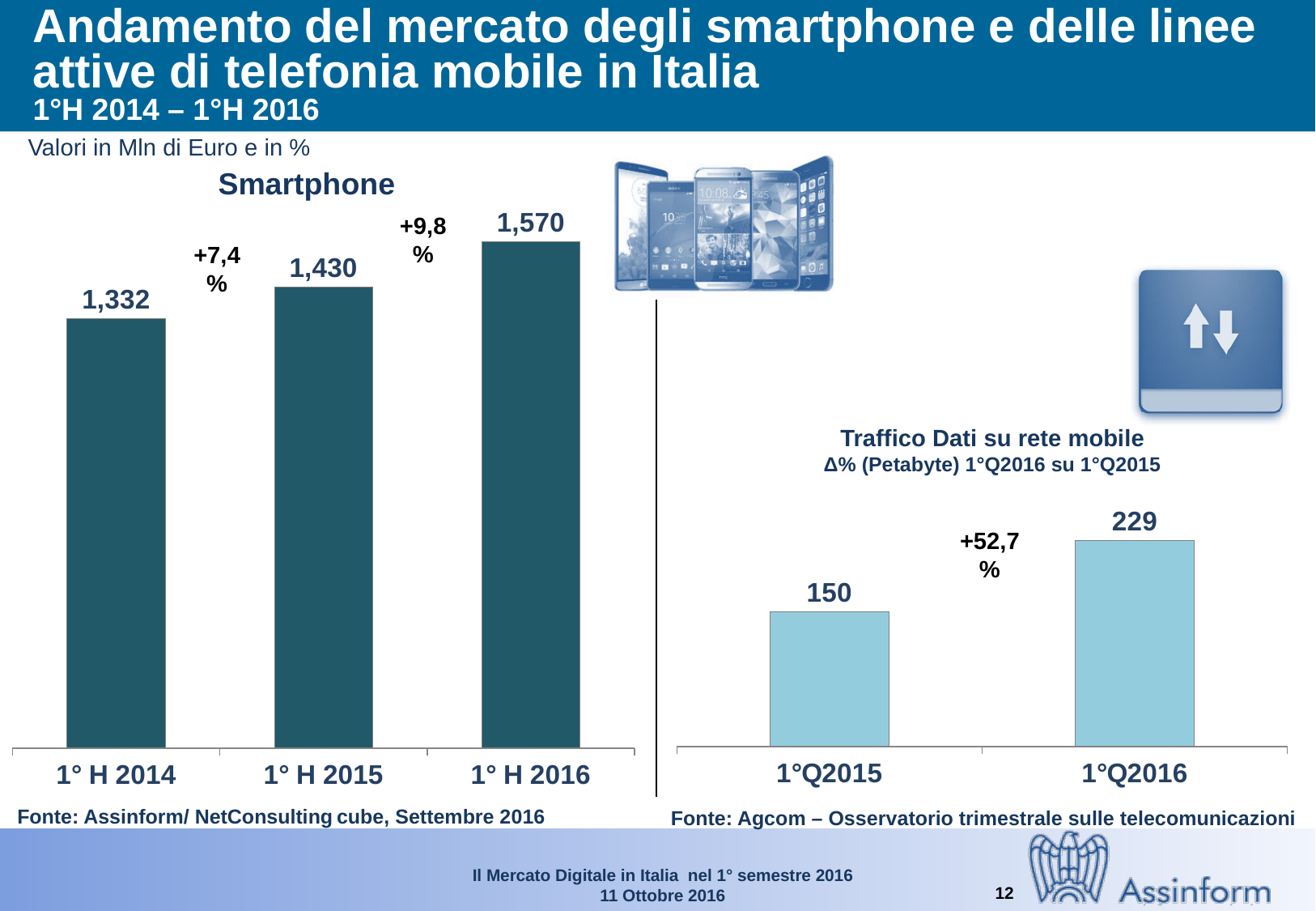
In the Smartphone chart, which period has the highest value? 1° H 2016 In the Traffico Dati su rete mobile chart, what is the difference between the values for 1°Q2016 and 1°Q2015? 79 In the Smartphone chart, what is the difference between the values for 1° H 2016 and 1° H 2015? 140 In the Smartphone chart, do the values rise or fall from 1° H 2014 to 1° H 2016? rise In the Smartphone chart, how many periods are plotted? 3 In the Smartphone chart, what is the value for 1° H 2014? 1,332 In the Traffico Dati su rete mobile chart, what is the value for 1°Q2015? 150 In the Smartphone chart, which period has the lowest value? 1° H 2014 In the Smartphone chart, what is the value for 1° H 2016? 1,570 What kind of chart is the Traffico Dati su rete mobile chart? bar chart In the Smartphone chart, what percentage change is shown between 1° H 2014 and 1° H 2015? +7,4% In the Traffico Dati su rete mobile chart, what percentage change is shown between 1°Q2015 and 1°Q2016? +52,7%